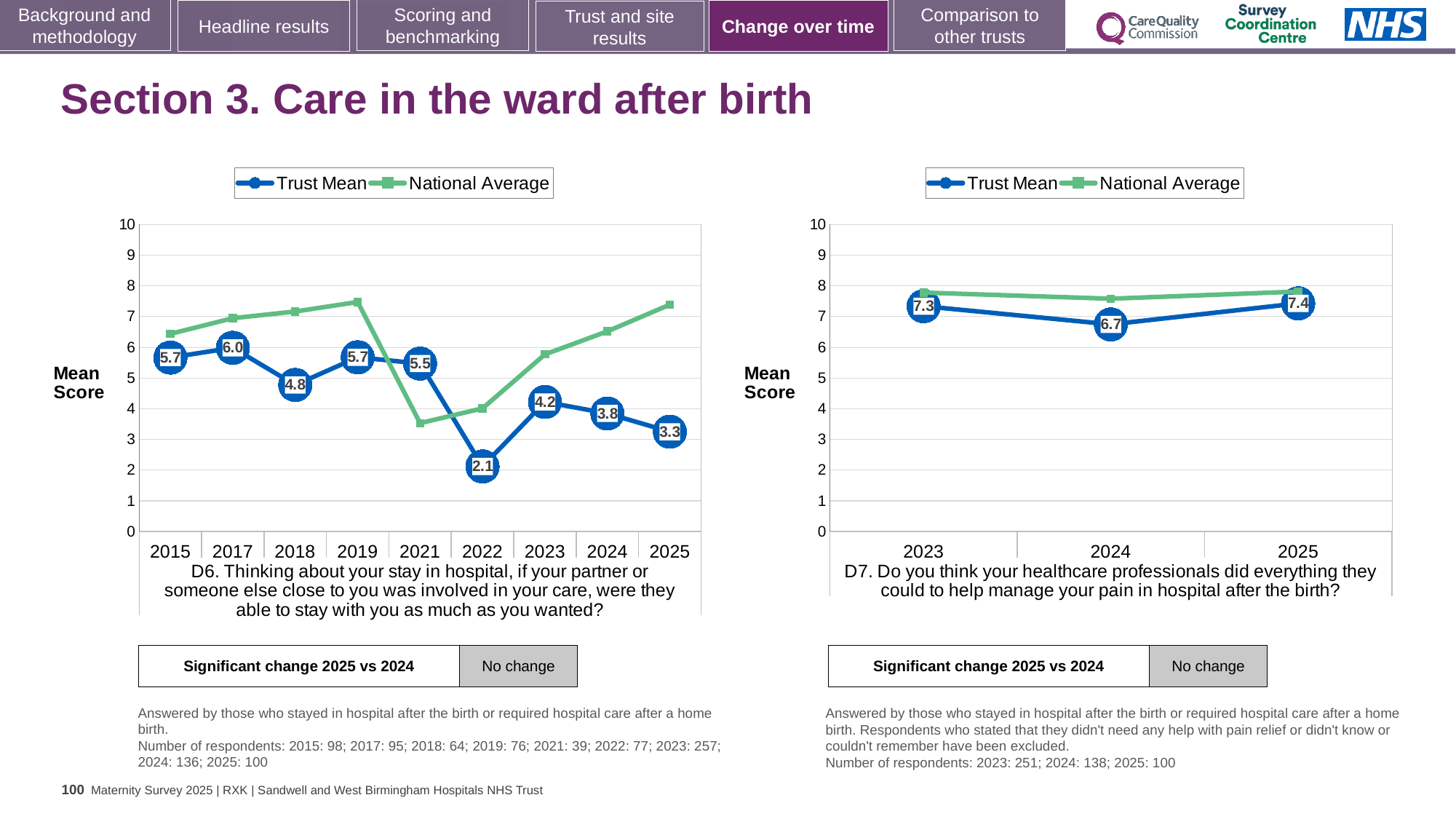
In the D6 chart on the left, which year has the lowest Trust Mean value? 2022 How many years are shown on the x axis of the D7 chart on the right? 3 In the D6 chart on the left, what is the Trust Mean value for 2025? 3.3 In the D7 chart on the right, which year has the lowest Trust Mean value? 2024 In the D6 chart on the left, what is the Trust Mean value for 2022? 2.1 In the D6 chart on the left, which year has the highest Trust Mean value? 2017 In the D6 chart on the left, is the National Average value for 2025 greater or less than 7? greater In the D7 chart on the right, what is the difference between the Trust Mean values for 2023 and 2024? 0.6 How many series does the legend of the D6 chart on the left list? 2 In the D6 chart on the left, what is the difference between the Trust Mean values for 2024 and 2025? 0.5 In the D7 chart on the right, what is the Trust Mean value for 2024? 6.7 In the D6 chart on the left, is the Trust Mean value for 2018 larger or smaller than the value for 2019? smaller